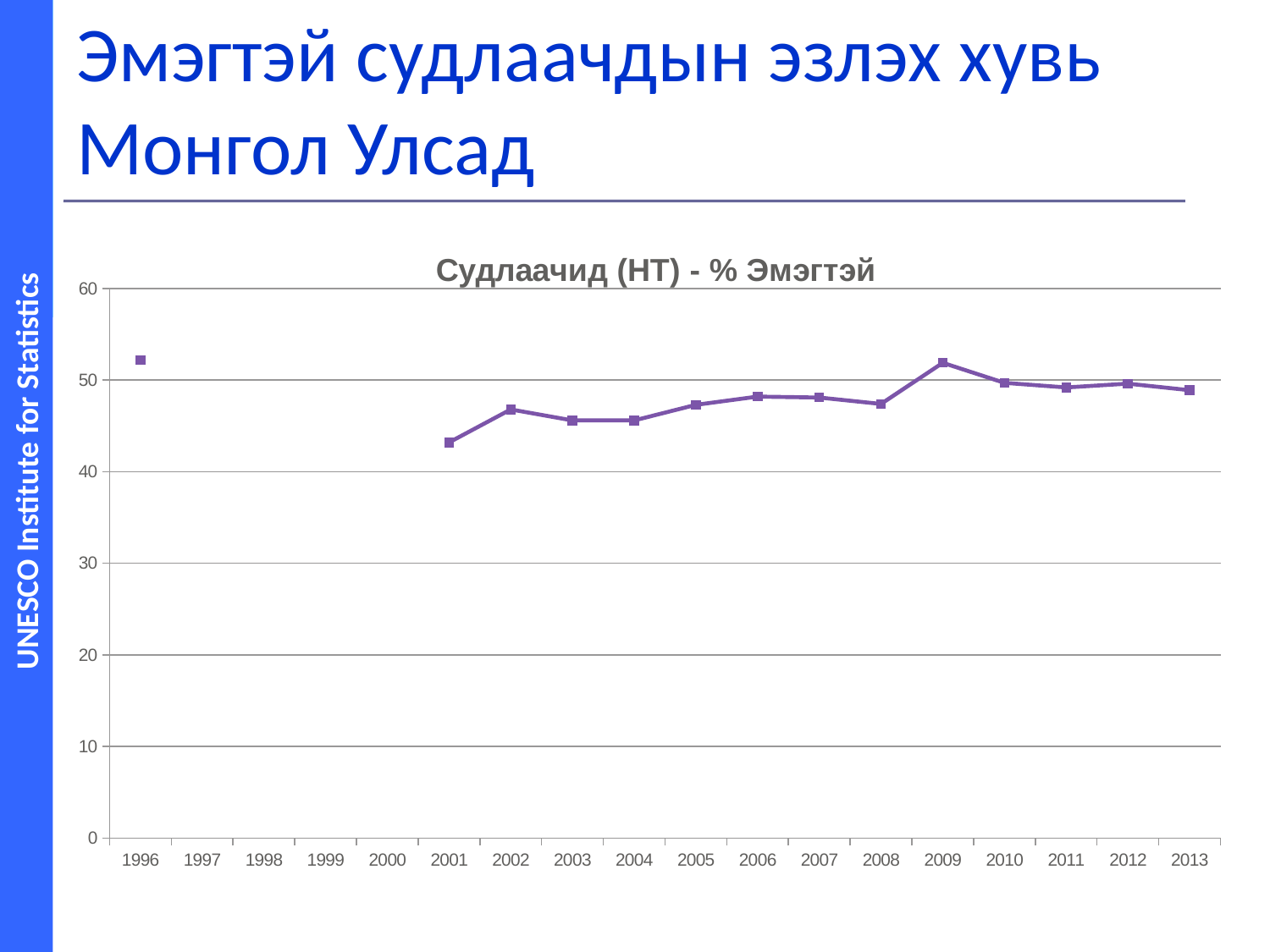
Which year has the lowest plotted value? 2001 Do the values generally rise or fall from 2001 to 2009? rise How many years are labelled on the x axis of the chart? 18 Is the value for 2013 greater or less than 50? less Is the value for 2009 greater or less than 50? greater Is the value for 2001 greater or less than 50? less What kind of chart is shown on the slide? line chart Which is larger, the value for 2008 or the value for 2009? 2009 What is the title of the chart? Судлаачид (HT) - % Эмэгтэй Which is larger, the value for 2001 or the value for 2009? 2009